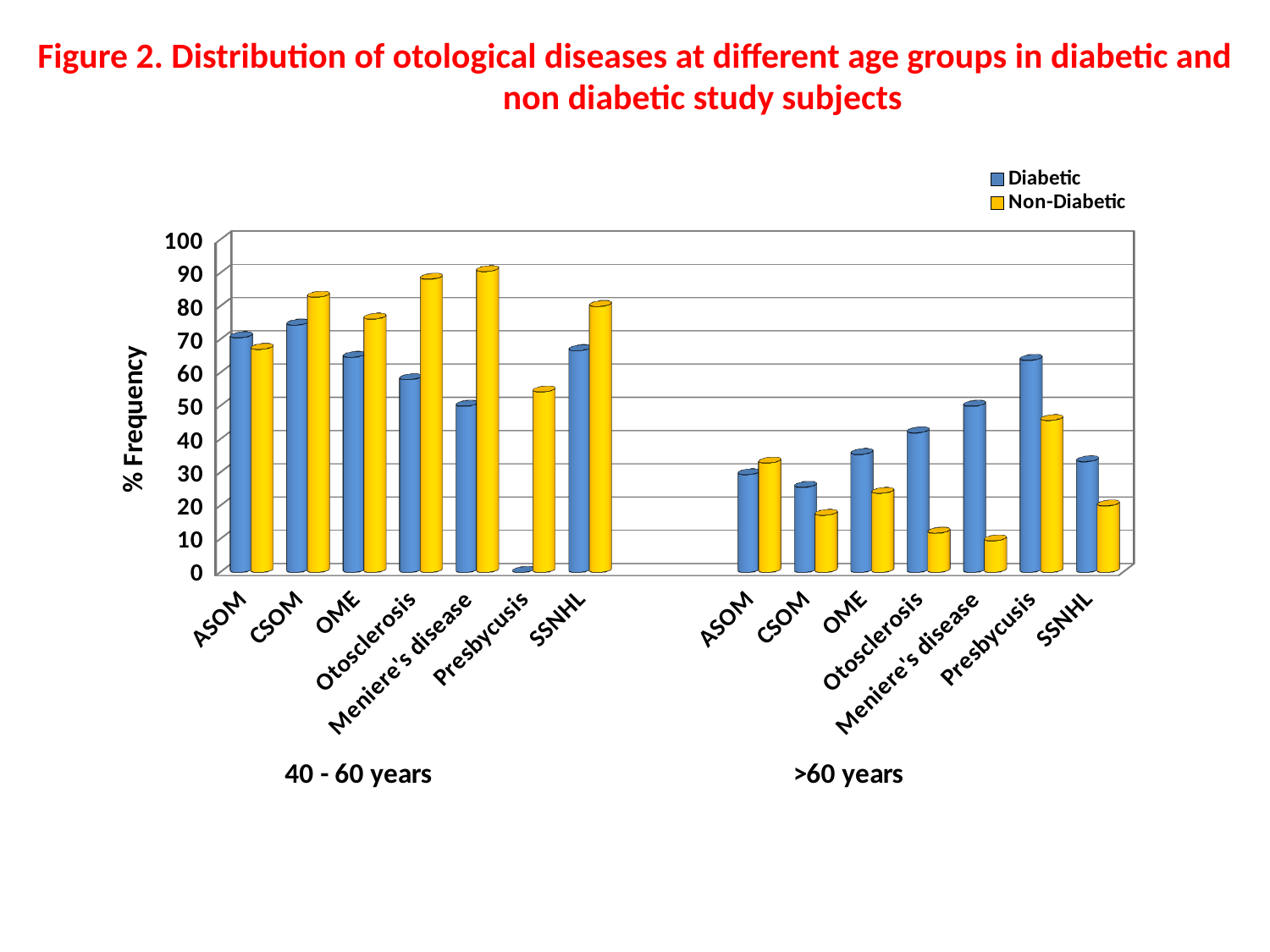
In the >60 years group, is the Non-Diabetic value for Meniere's disease greater or less than 20? less In the 40 - 60 years group, is the Diabetic value for Meniere's disease greater or less than 60? less In the >60 years group, which is larger for Otosclerosis, the Diabetic or the Non-Diabetic value? Diabetic What kind of chart is shown on the slide? bar chart Which series is shown in yellow? Non-Diabetic In the 40 - 60 years group, which disease has the lowest Diabetic value? Presbycusis In the >60 years group, is the Diabetic value for Presbycusis greater or less than 50? greater In the 40 - 60 years group, which disease has the highest Non-Diabetic value? Meniere's disease How many disease categories are shown in the 40 - 60 years group? 7 How many series does the legend list? 2 What is the label of the y axis? % Frequency